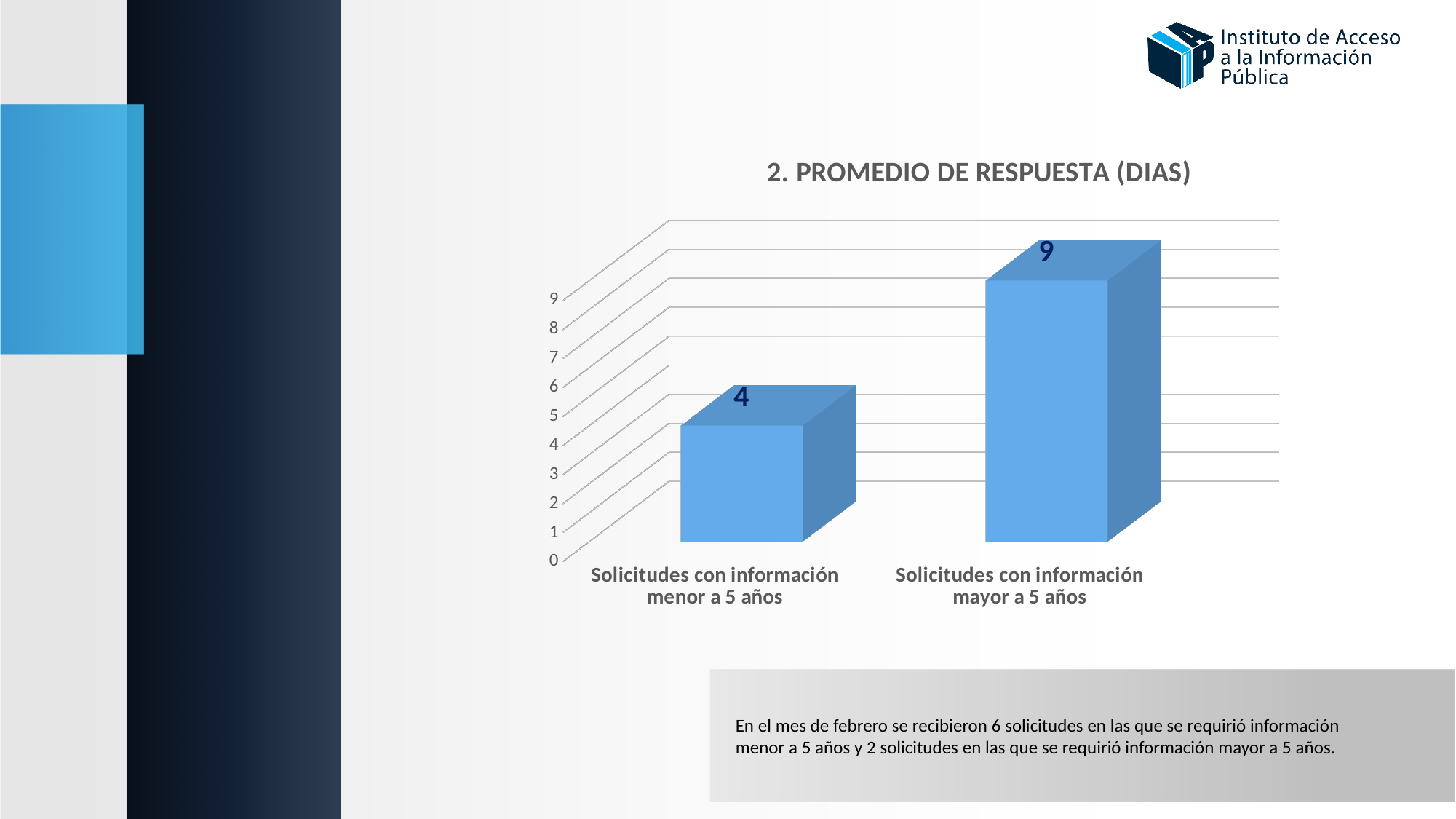
What is the title of the chart? 2. PROMEDIO DE RESPUESTA (DIAS) Is the value for 'Solicitudes con información menor a 5 años' greater or less than 6? less What kind of chart is shown on the slide? Bar chart Which category has the highest average response time? Solicitudes con información mayor a 5 años Which category has the lowest average response time? Solicitudes con información menor a 5 años What is the average response time in days for 'Solicitudes con información mayor a 5 años'? 9 What is the highest value shown on the vertical axis of the chart? 9 Which is larger: the average response for 'menor a 5 años' or for 'mayor a 5 años'? mayor a 5 años What is the average response time in days for 'Solicitudes con información menor a 5 años'? 4 What is the difference in days between the average response for requests with information mayor a 5 años and menor a 5 años? 5 How many categories are shown in the chart? 2 Is the value for 'Solicitudes con información mayor a 5 años' greater or less than 5? greater